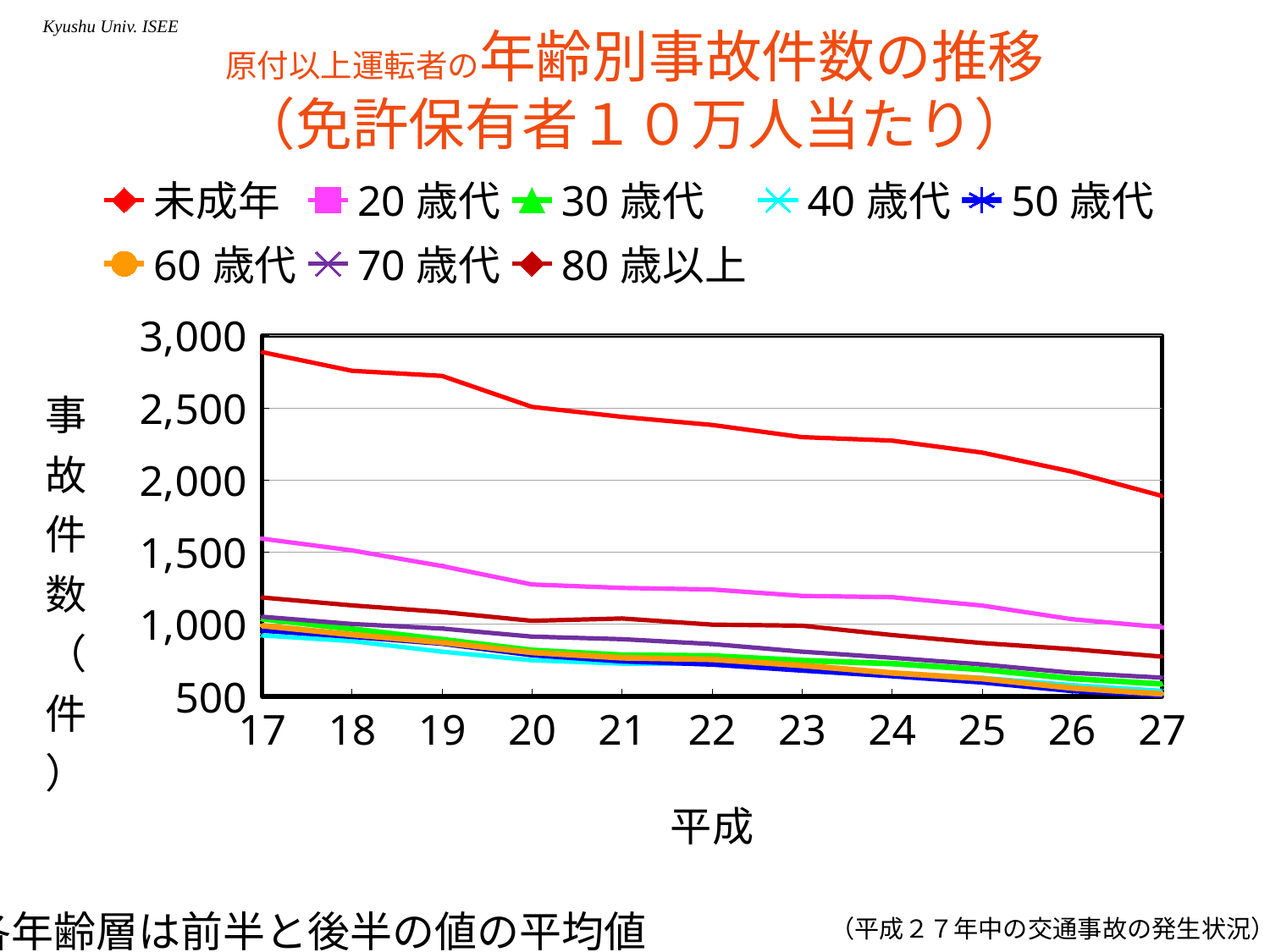
Which age group has the highest accident count across all years shown? 未成年 Is the value for 80歳以上 in 平成17 greater or less than 1,000? greater Is the value for 未成年 in 平成17 greater or less than 2,500? greater What kind of chart is shown on the slide? line chart How many years are plotted along the x axis? 11 In 平成17, which is larger: the value for 20歳代 or the value for 80歳以上? 20歳代 Does the value for 未成年 rise or fall from 平成17 to 平成27? fall What is the label on the x axis of the chart? 平成 Is the value for 20歳代 in 平成20 greater or less than 1,500? less How many series does the legend list? 8